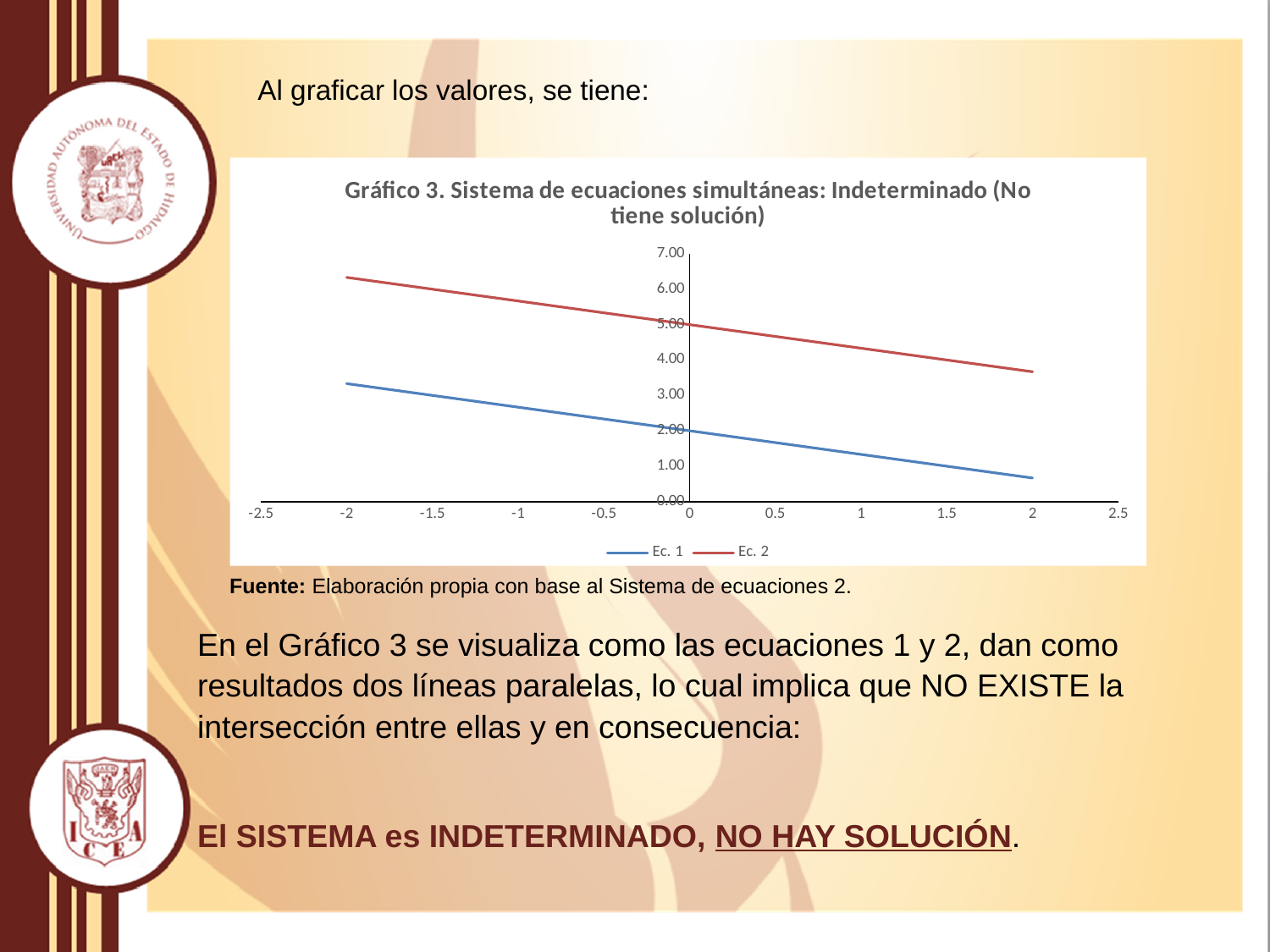
Is the value of Ec. 2 at x = 2 greater or less than 3.00? greater What kind of chart is shown on the slide? line chart Is the value of Ec. 1 at x = -2 greater or less than 2.00? greater What is the highest value shown on the y axis? 7.00 Is the value of Ec. 2 at x = -2 greater or less than 5.00? greater Do the values of Ec. 1 rise or fall as x increases? fall Do the values of Ec. 2 rise or fall as x increases? fall How many series does the legend list? 2 What are the names of the two series in the legend? Ec. 1 and Ec. 2 Which series has the higher values across the whole x range, Ec. 1 or Ec. 2? Ec. 2 What is the title of the chart? Gráfico 3. Sistema de ecuaciones simultáneas: Indeterminado (No tiene solución)